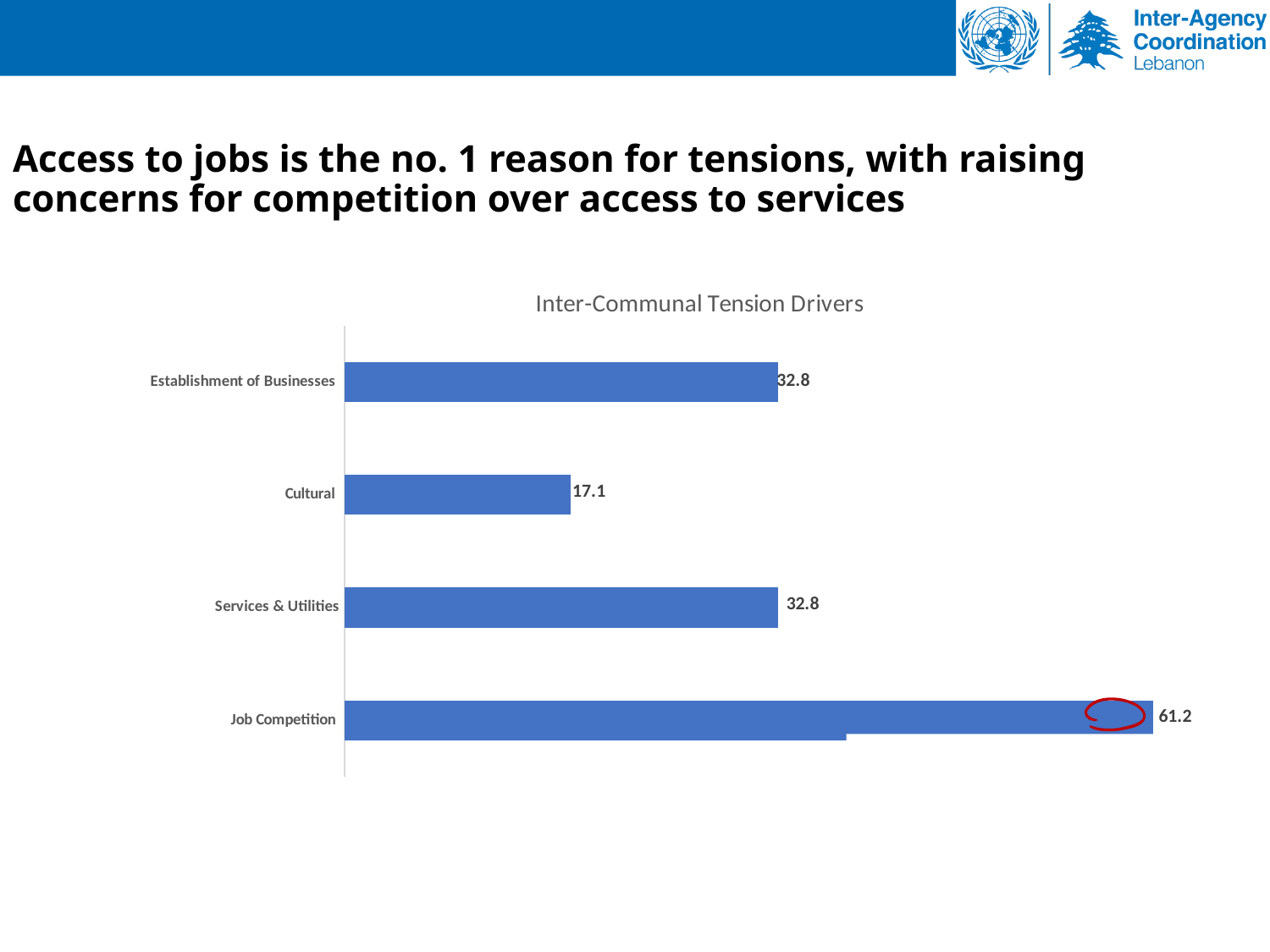
What is the value for Cultural? 17.1 What is the value for Establishment of Businesses? 32.8 Which is larger, the value for Cultural or the value for Establishment of Businesses? Establishment of Businesses Which category has the lowest value? Cultural Which category has the highest value? Job Competition What kind of chart is shown on the slide? Bar chart How many categories are shown in the chart? 4 What is the value for Job Competition? 61.2 What is the difference between the values for Job Competition and Cultural? 44.1 What is the value for Services & Utilities? 32.8 What is the difference between the values for Job Competition and Services & Utilities? 28.4 What is the title of the chart? Inter-Communal Tension Drivers